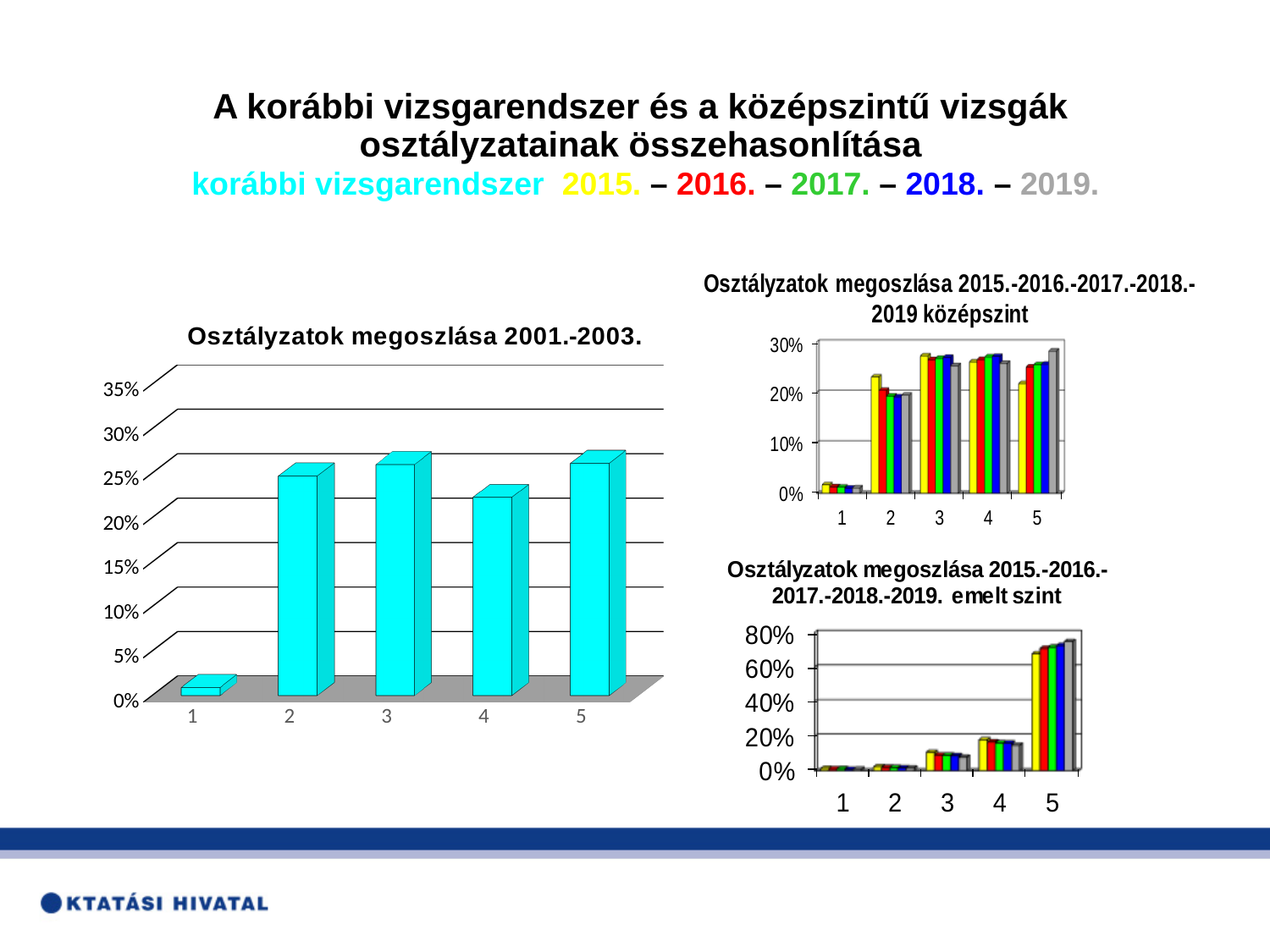
In the 'Osztályzatok megoszlása 2015.-2016.-2017.-2018.-2019. emelt szint' chart, which category has the highest values? 5 In the 'Osztályzatok megoszlása 2001.-2003.' chart, is the value for category 1 greater or less than 5%? less How many categories are shown on the x axis of the 'Osztályzatok megoszlása 2001.-2003.' chart? 5 In the 'Osztályzatok megoszlása 2015.-2016.-2017.-2018.-2019. emelt szint' chart, are the values for category 5 greater or less than 60%? greater In the 'Osztályzatok megoszlása 2015.-2016.-2017.-2018.-2019 középszint' chart, is the yellow bar for category 2 greater or less than 20%? greater In the 'Osztályzatok megoszlása 2015.-2016.-2017.-2018.-2019. emelt szint' chart, do the values rise or fall from category 1 to category 5? rise In the 'Osztályzatok megoszlása 2001.-2003.' chart, which is larger, the value for category 3 or category 4? category 3 In the 'Osztályzatok megoszlása 2001.-2003.' chart, which category has the lowest value? 1 In the 'Osztályzatok megoszlása 2015.-2016.-2017.-2018.-2019 középszint' chart, which category has the lowest values? 1 What is the title of the large chart on the left side of the slide? Osztályzatok megoszlása 2001.-2003. What kind of chart is the 'Osztályzatok megoszlása 2001.-2003.' chart on the left? bar chart